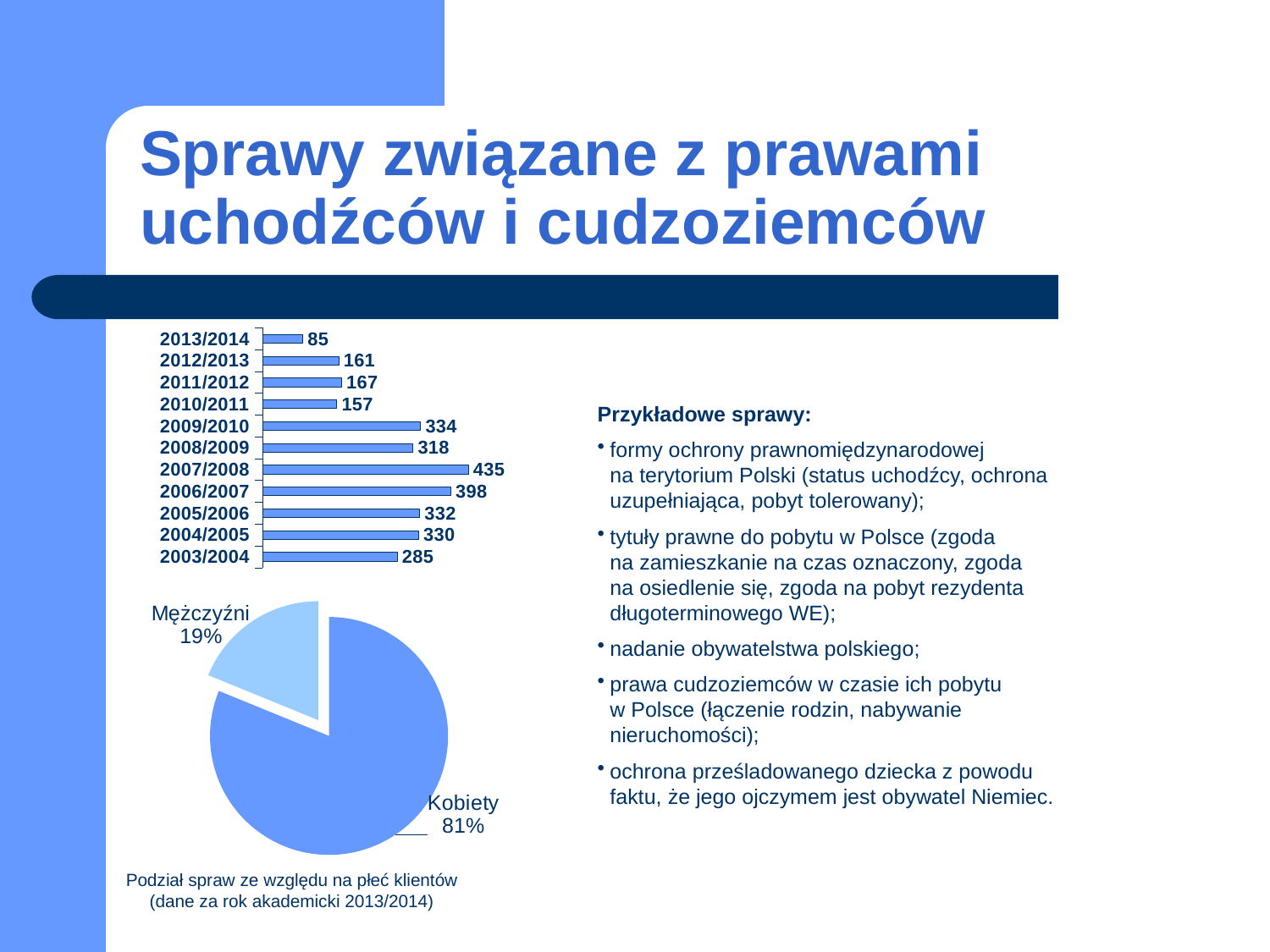
In the bar chart at the top left, which academic year has the highest value? 2007/2008 In the pie chart at the bottom left, what share is labelled Kobiety? 81% In the bar chart at the top left, what is the difference between the values for 2007/2008 and 2006/2007? 37 In the bar chart at the top left, what is the value for 2003/2004? 285 What kind of chart is the chart at the bottom left of the slide? pie chart How many academic years are shown in the bar chart at the top left? 11 In the bar chart at the top left, what is the value for 2007/2008? 435 In the bar chart at the top left, what is the value for 2013/2014? 85 In the pie chart at the bottom left, what share is labelled Mężczyźni? 19% In the bar chart at the top left, which academic year has the lowest value? 2013/2014 What kind of chart is the chart at the top left of the slide? bar chart In the bar chart at the top left, which is larger, the value for 2009/2010 or the value for 2008/2009? 2009/2010